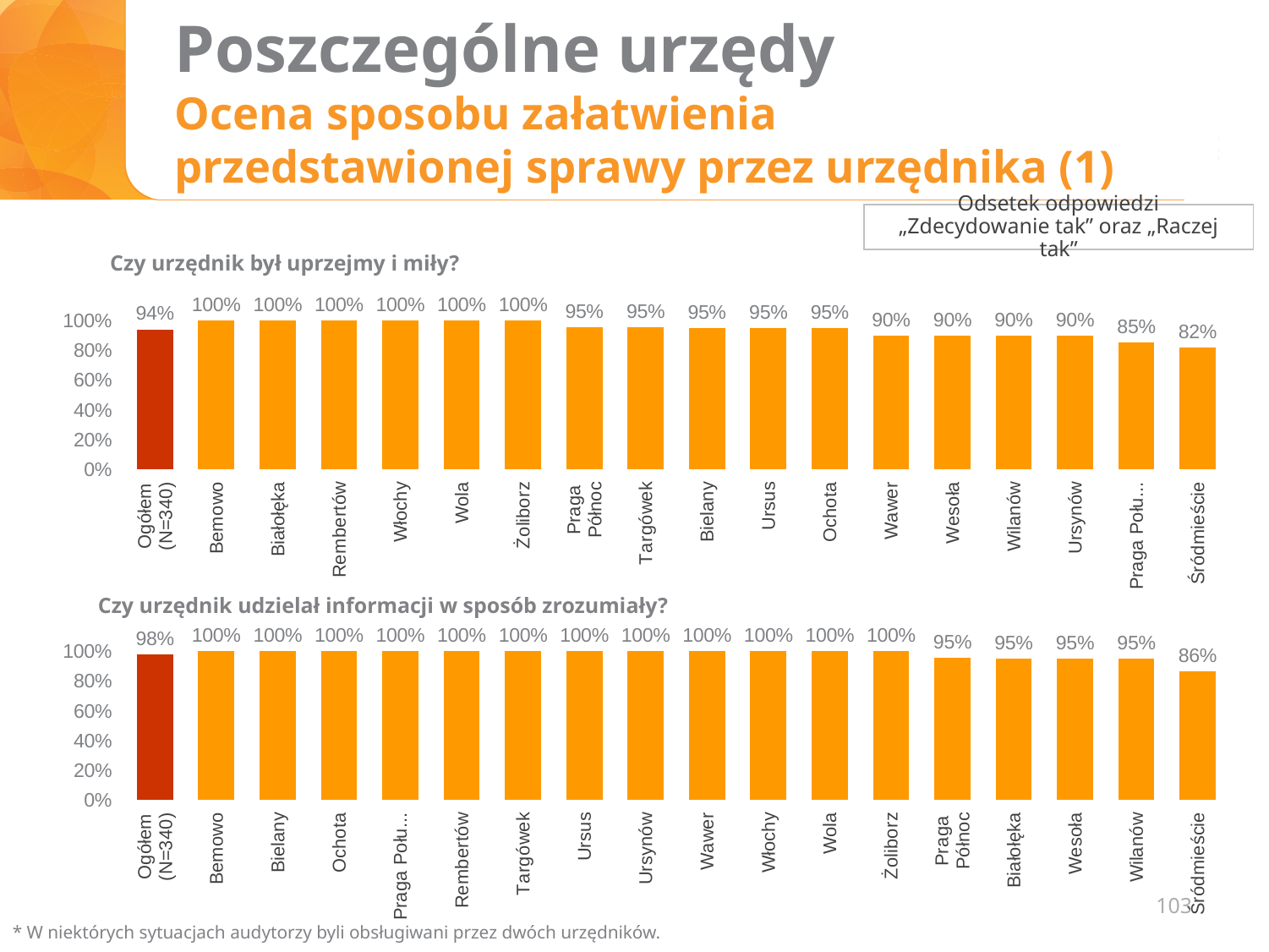
In the chart "Czy urzędnik był uprzejmy i miły?", which is larger, the value for Targówek or the value for Ursynów? Targówek In the chart "Czy urzędnik udzielał informacji w sposób zrozumiały?", which category has the lowest value? Śródmieście In the chart "Czy urzędnik był uprzejmy i miły?", what is the value for Ogółem (N=340)? 94% What type of chart is the chart "Czy urzędnik udzielał informacji w sposób zrozumiały?"? Bar chart In the chart "Czy urzędnik był uprzejmy i miły?", what is the value for Śródmieście? 82% How many bars are plotted in the chart "Czy urzędnik był uprzejmy i miły?"? 18 In the chart "Czy urzędnik był uprzejmy i miły?", which category has the lowest value? Śródmieście In the chart "Czy urzędnik udzielał informacji w sposób zrozumiały?", what is the value for Wilanów? 95% In the chart "Czy urzędnik udzielał informacji w sposób zrozumiały?", what is the value for Ogółem (N=340)? 98% In the chart "Czy urzędnik udzielał informacji w sposób zrozumiały?", do the values rise or fall from left to right after the Ogółem bar? Fall In the chart "Czy urzędnik udzielał informacji w sposób zrozumiały?", what is the difference between the values for Bemowo and Śródmieście? 14 percentage points In the chart "Czy urzędnik był uprzejmy i miły?", what is the difference between the values for Wawer and Śródmieście? 8 percentage points